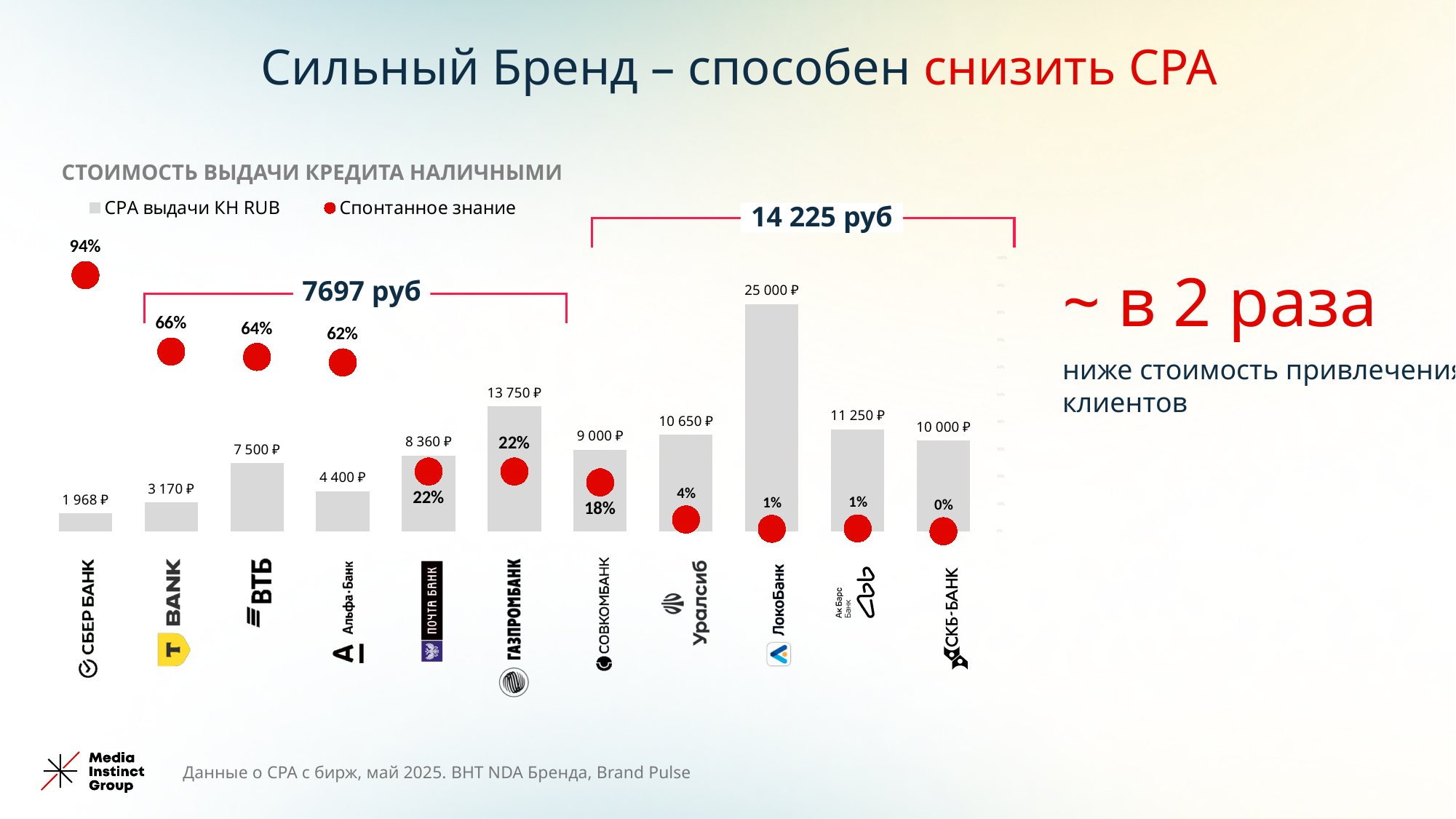
What is the title of the chart? СТОИМОСТЬ ВЫДАЧИ КРЕДИТА НАЛИЧНЫМИ What kind of chart is used to show CPA выдачи КН RUB? Bar chart How many banks are shown on the chart? 11 What is the difference in CPA выдачи КН between ЛокоБанк and Сбербанк? 23 032 ₽ What is the Спонтанное знание value for ВТБ? 64% Which has a higher CPA выдачи КН, Уралсиб or Совкомбанк? Уралсиб What is the CPA выдачи КН value for Газпромбанк? 13 750 ₽ Which bank has the highest Спонтанное знание? Сбербанк What is the CPA выдачи КН value for Сбербанк? 1 968 ₽ How many series does the legend list? 2 Which bank has the highest CPA выдачи КН? ЛокоБанк Which bank has the lowest Спонтанное знание? СКБ-Банк